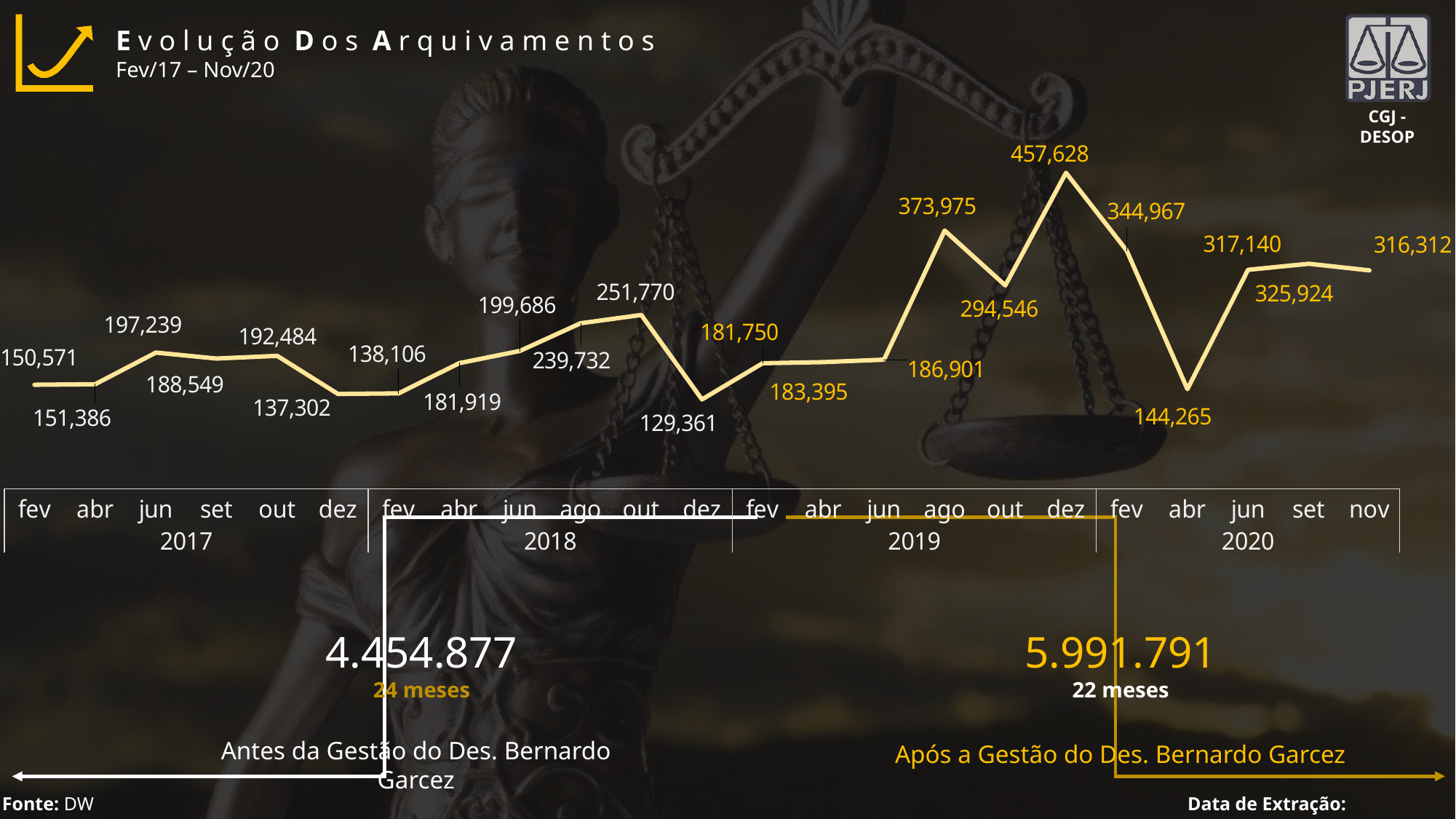
What is the difference between the highest value (457,628) and the lowest value (129,361)? 328,267 What period does the chart cover, according to the subtitle? Fev/17 – Nov/20 What is the value for the last point (nov 2020)? 316,312 What is the highest value plotted on the chart? 457,628 Which is larger, the value for out 2018 (251,770) or the value for out 2019 (294,546)? 294,546 (out 2019) What kind of chart is shown on the slide? line chart What is the lowest value plotted on the chart? 129,361 What is the title of the chart? Evolução Dos Arquivamentos How many data points are plotted on the chart? 23 What is the value for the first point (fev 2017)? 150,571 What total is shown for the 24-month period 'Antes da Gestão do Des. Bernardo Garcez'? 4.454.877 What is the value for ago 2019? 373,975